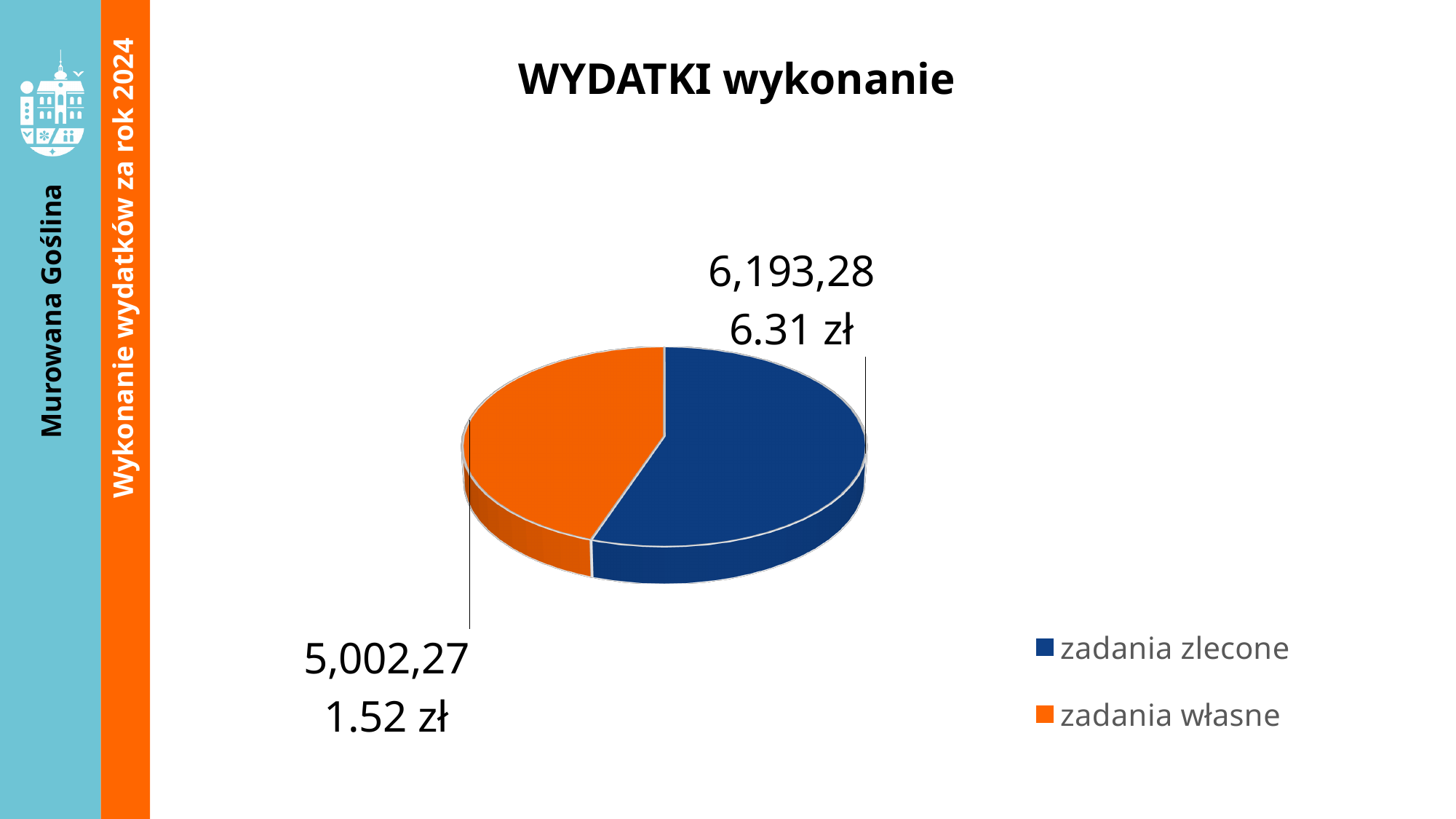
What is the title of the chart? WYDATKI wykonanie What is the total of the two values shown in the pie chart? 11,195,557.83 zł What is the difference between the values for zadania zlecone and zadania własne? 1,191,014.79 zł Which colour represents zadania własne in the chart? orange Which is larger, zadania zlecone or zadania własne? zadania zlecone How many entries does the legend list? 2 What kind of chart is shown on the slide? pie chart What is the value shown for zadania własne? 5,002,271.52 zł Which category has the largest slice of the pie? zadania zlecone What is the value shown for zadania zlecone? 6,193,286.31 zł Which category has the smallest slice of the pie? zadania własne How many slices does the pie chart have? 2